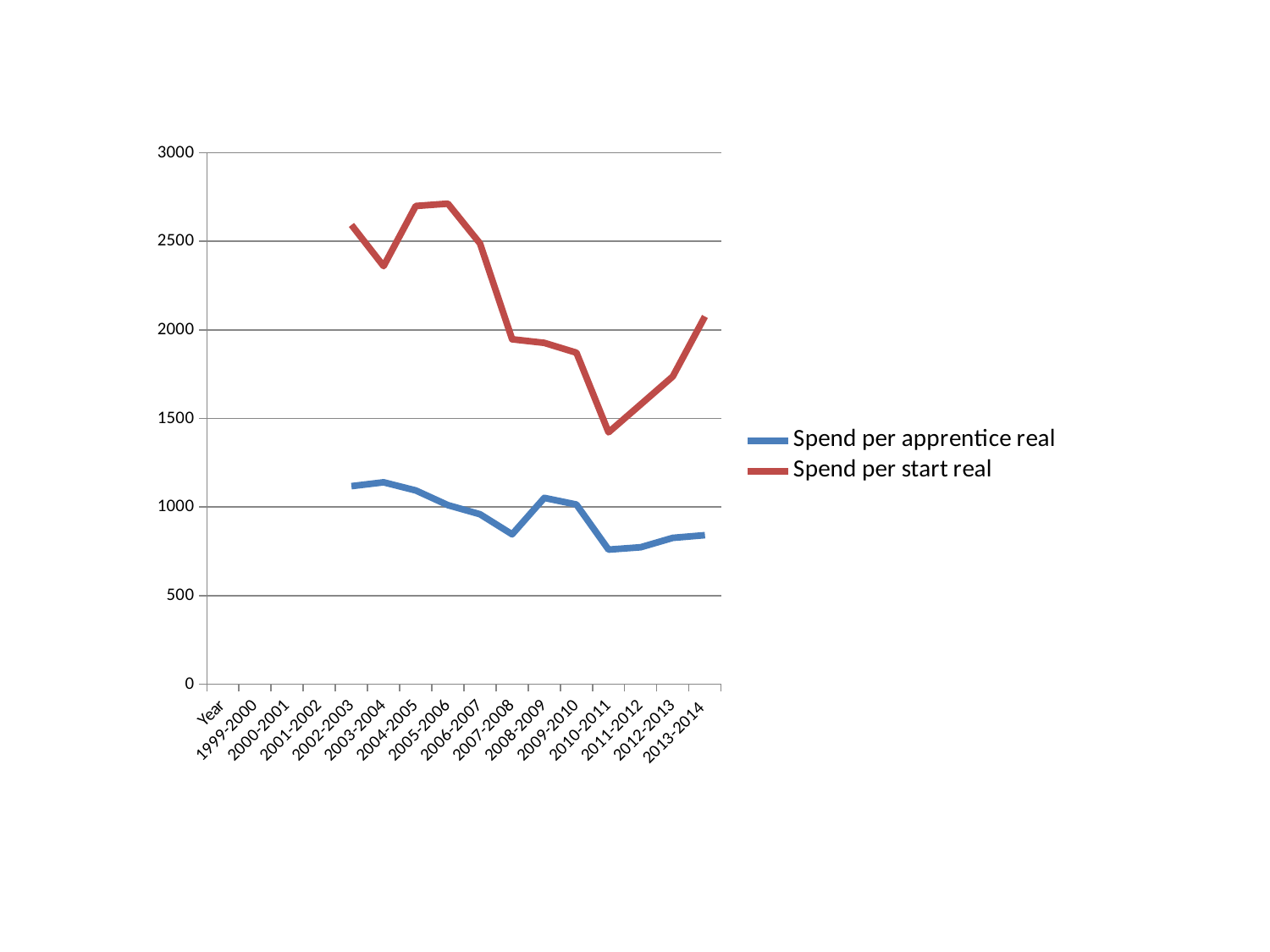
What kind of chart is shown on the slide? line chart Is the value for Spend per start real in 2005-2006 greater or less than 2500? greater Is the value for Spend per apprentice real in 2002-2003 greater or less than 1000? greater How many series does the legend list? 2 Which series has the higher value in 2013-2014, Spend per apprentice real or Spend per start real? Spend per start real Does Spend per start real rise or fall between 2010-2011 and 2013-2014? rise In which year is the value for Spend per start real lowest? 2010-2011 Which series is drawn in blue? Spend per apprentice real For Spend per start real, is the value in 2003-2004 higher or lower than in 2004-2005? lower Which series is drawn in red? Spend per start real Is the value for Spend per apprentice real in 2007-2008 greater or less than 1000? less